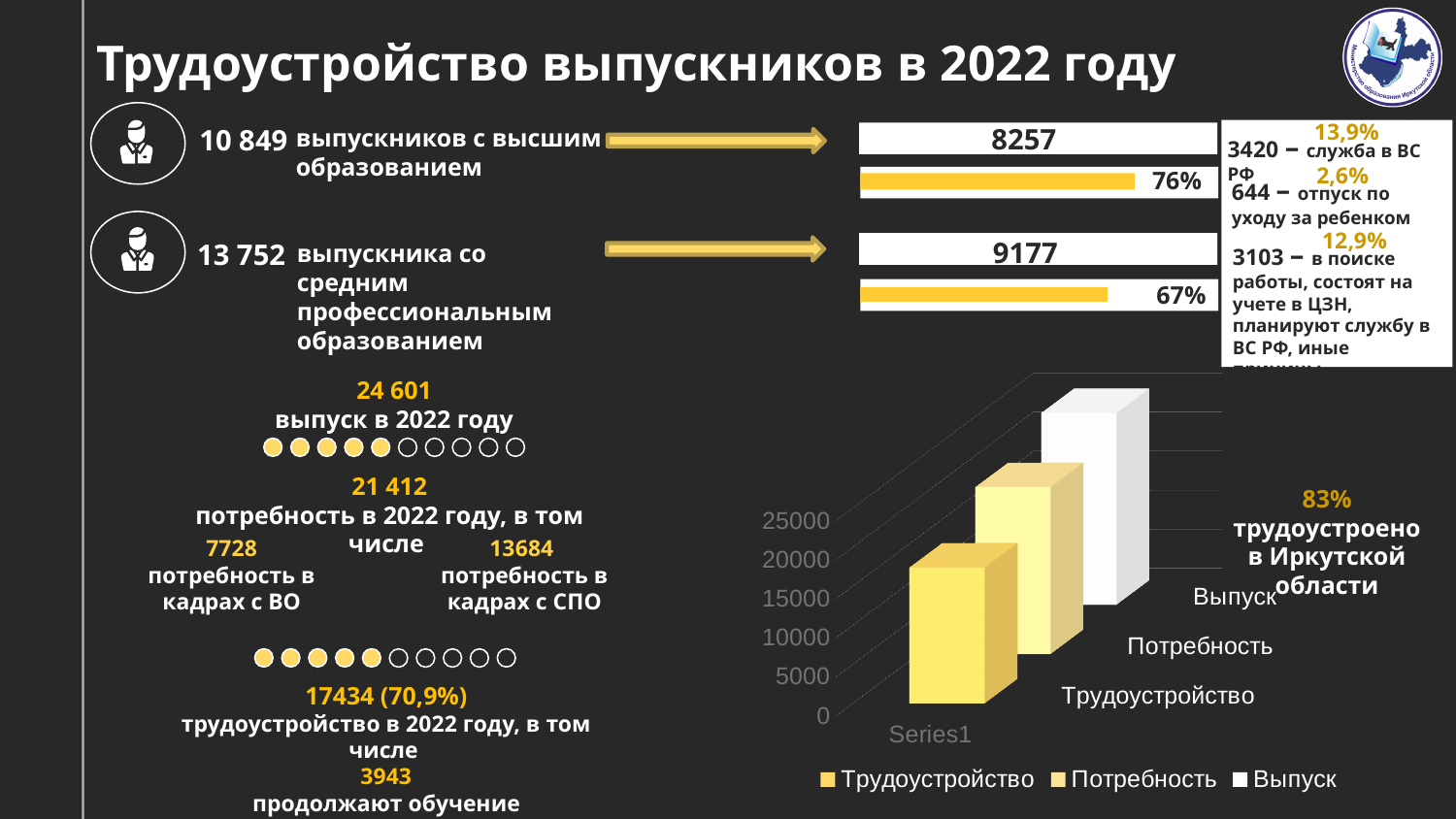
How many categories are shown on the category axis of the bar chart? 1 Which series has the tallest bar in the bar chart? Выпуск What is the label shown on the category axis of the bar chart? Series1 What kind of chart is shown at the bottom right of the slide? bar chart In the bar chart, which bar is taller: Потребность or Трудоустройство? Потребность In the bar chart, is the value for Трудоустройство greater or less than 20000? less What is the highest tick value shown on the value axis of the bar chart? 25000 In the bar chart, is the value for Выпуск greater or less than 20000? greater In the bar chart, which bar is taller: Выпуск or Потребность? Выпуск Which series has the shortest bar in the bar chart? Трудоустройство How many series does the legend of the bar chart list? 3 What are the three series named in the legend of the bar chart? Трудоустройство, Потребность, Выпуск